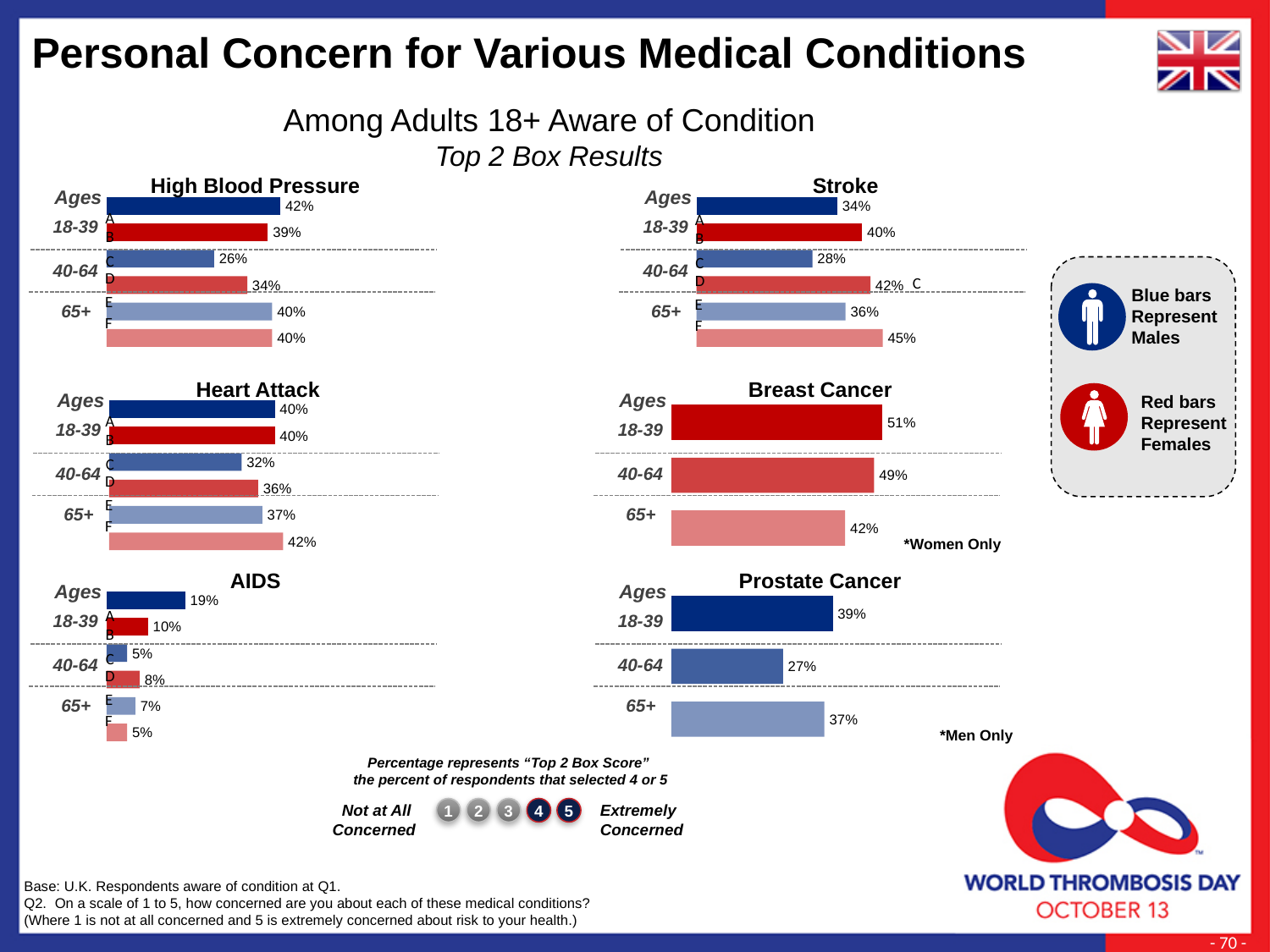
In the AIDS chart, what is the difference between the male and female values for ages 18-39? 9% In the Stroke chart, what is the value for females aged 65+? 45% In the High Blood Pressure chart, what is the value for males aged 18-39? 42% In the Breast Cancer chart, which age group has the highest value? 18-39 In the Heart Attack chart, which is larger for ages 65+: the male value or the female value? the female value In the Breast Cancer chart, do the values rise or fall as age increases from 18-39 to 65+? fall In the Prostate Cancer chart, which age group has the lowest value? 40-64 In the High Blood Pressure chart, what is the value for females aged 40-64? 34% According to the legend, what do the blue bars represent? Males What kind of chart is used for Prostate Cancer? bar chart In the Stroke chart, what is the difference between the female and male values for ages 40-64? 14% How many age groups are shown in the Breast Cancer chart? 3